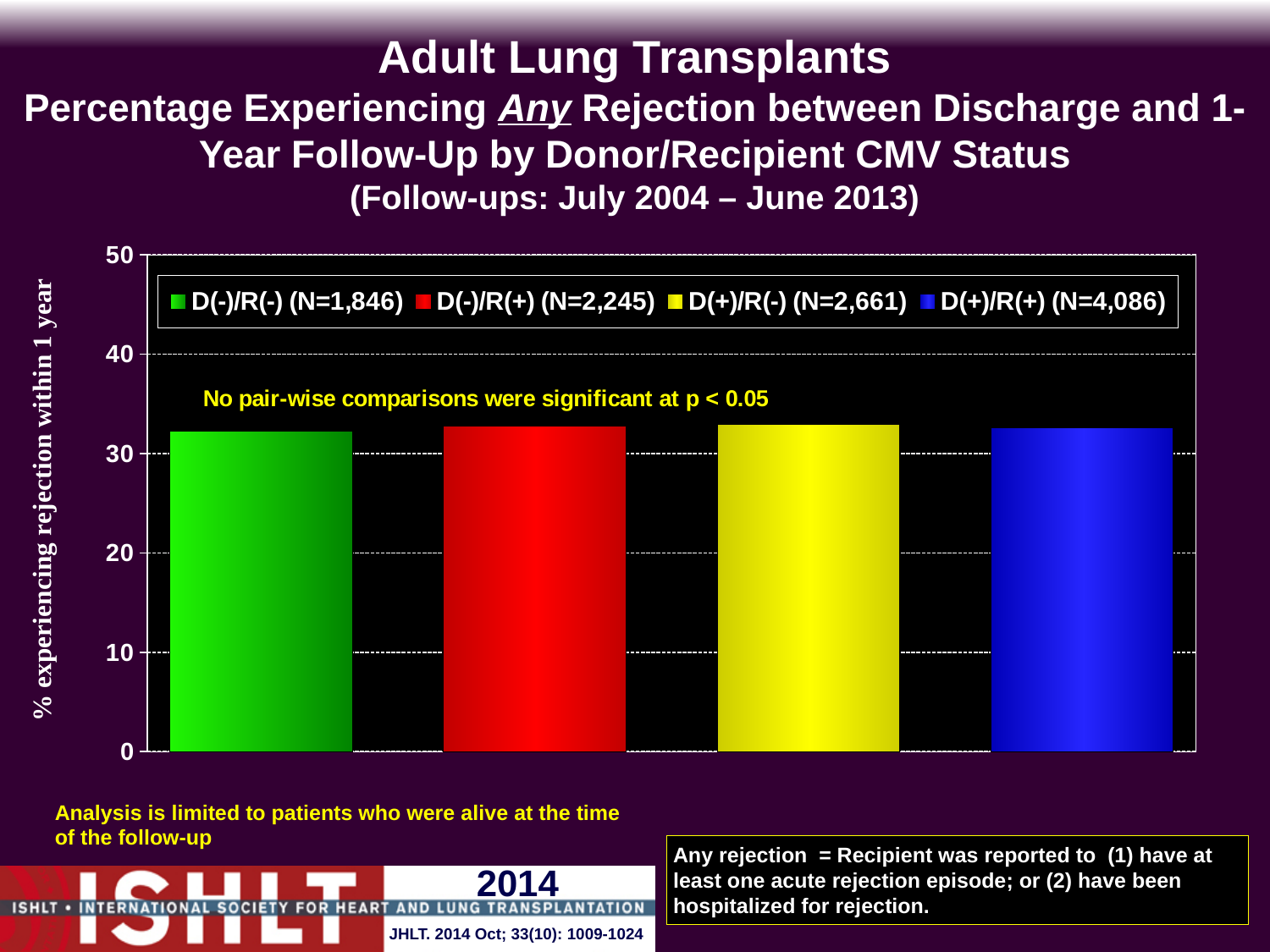
What is the sample size (N) shown in the legend for the D(+)/R(+) group? 4,086 What kind of chart is shown on the slide? bar chart Is the value for D(-)/R(+) greater or less than 40? less What is the label of the y axis? % experiencing rejection within 1 year Is the value for D(-)/R(-) greater or less than 30? greater Is the value for D(+)/R(+) greater or less than 40? less What colour is the bar for the D(+)/R(-) group? yellow How many bars are plotted in the chart? 4 How many series does the legend list? 4